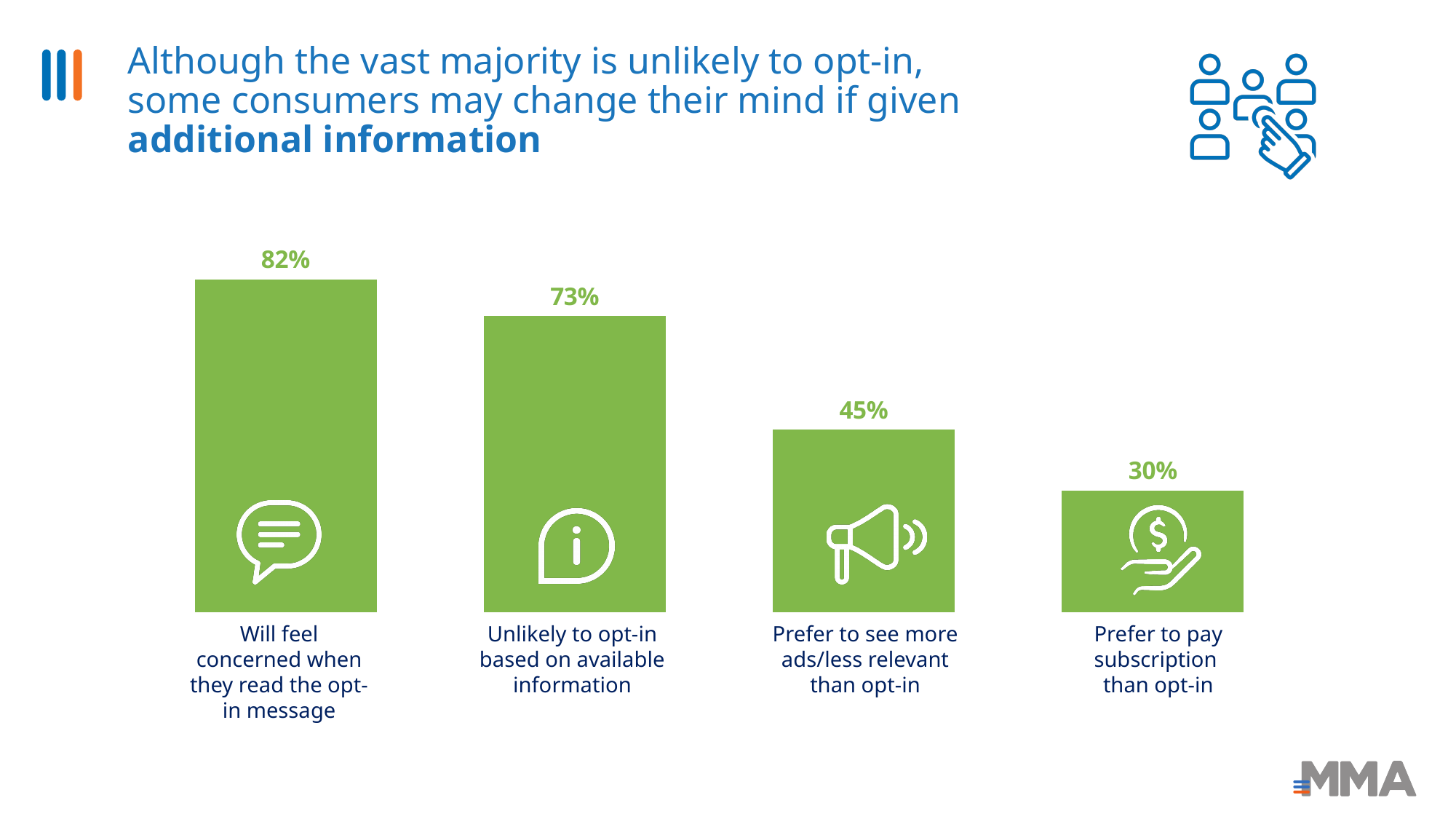
What percentage is unlikely to opt-in based on available information? 73% Do the values rise or fall from left to right across the chart? Fall What percentage prefer to pay subscription than opt-in? 30% How many categories are shown in the chart? 4 Which category has the highest value? Will feel concerned when they read the opt-in message Which category has the lowest value? Prefer to pay subscription than opt-in What percentage prefer to see more ads/less relevant than opt-in? 45% What percentage will feel concerned when they read the opt-in message? 82% What kind of chart is shown on the slide? Bar chart What is the difference between the value for 'Will feel concerned when they read the opt-in message' and 'Unlikely to opt-in based on available information'? 9% Which is larger: the value for 'Prefer to see more ads/less relevant than opt-in' or 'Prefer to pay subscription than opt-in'? Prefer to see more ads/less relevant than opt-in What is the difference between the value for 'Prefer to see more ads/less relevant than opt-in' and 'Prefer to pay subscription than opt-in'? 15%